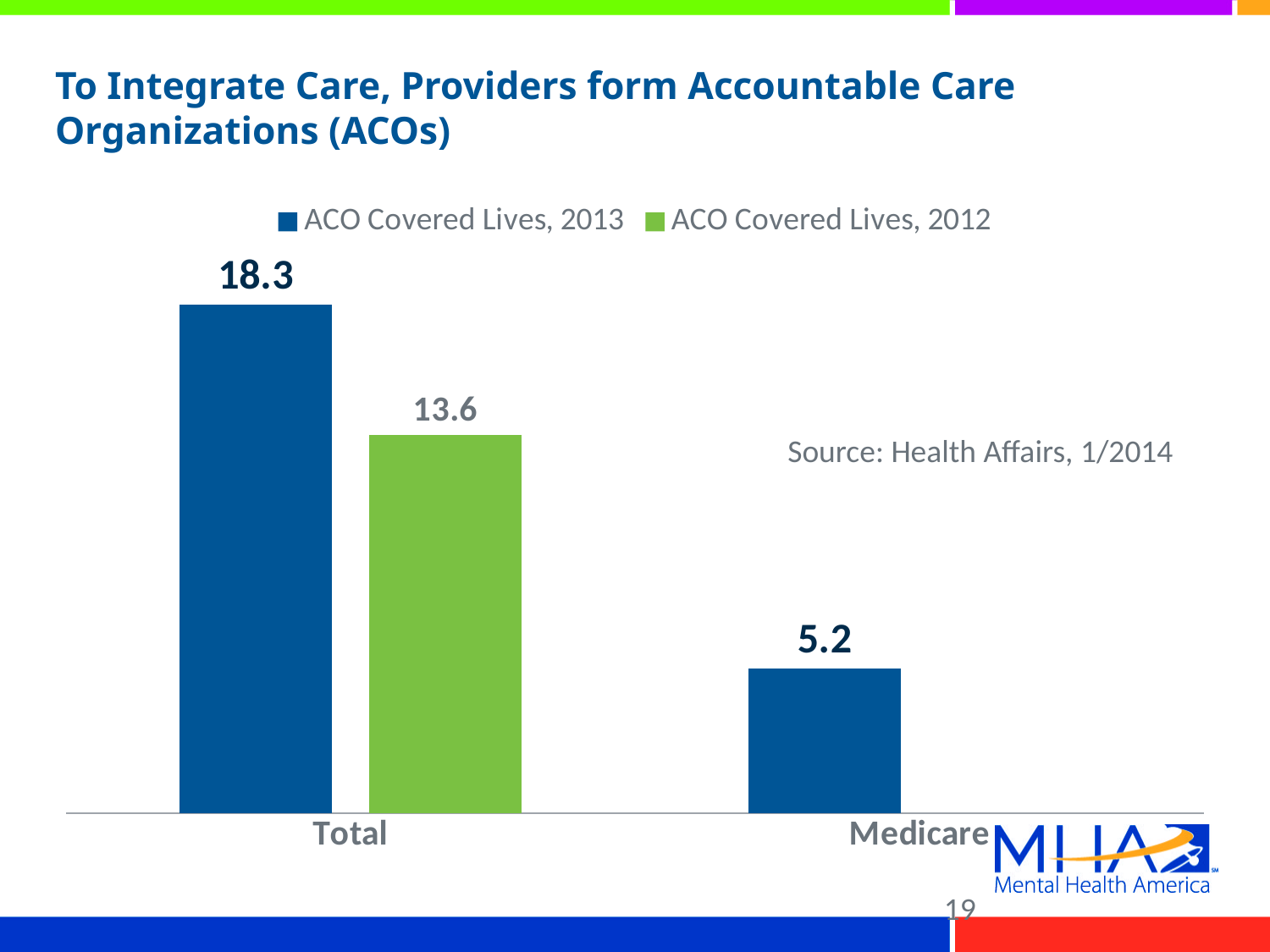
What colour is the ACO Covered Lives, 2012 series? Green What kind of chart is shown on the slide? Bar chart Which is larger for Total: ACO Covered Lives, 2013 or ACO Covered Lives, 2012? ACO Covered Lives, 2013 What is the value of ACO Covered Lives, 2013 for Total? 18.3 Which bar has the highest value on the chart? ACO Covered Lives, 2013 for Total How many categories are shown on the x axis? 2 What is the difference between ACO Covered Lives, 2013 and ACO Covered Lives, 2012 for Total? 4.7 What is the value of ACO Covered Lives, 2012 for Total? 13.6 Which bar has the lowest value on the chart? ACO Covered Lives, 2013 for Medicare How many series does the legend list? 2 What is the difference between the 2013 values for Total and Medicare? 13.1 What is the value of ACO Covered Lives, 2013 for Medicare? 5.2